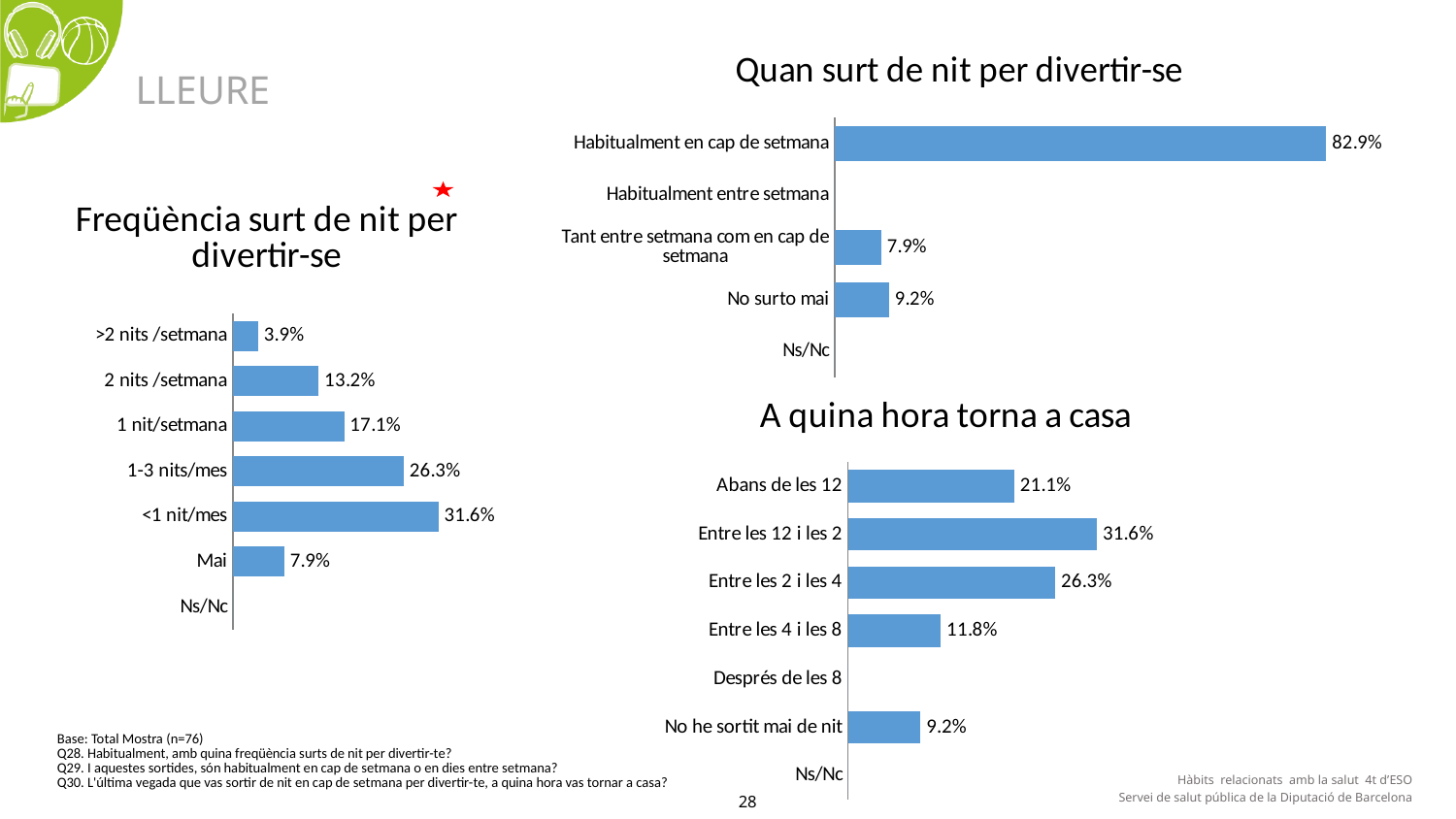
In the chart 'A quina hora torna a casa', what is the value for 'Entre les 4 i les 8'? 11.8% In the chart 'Freqüència surt de nit per divertir-se', what is the difference between '1-3 nits/mes' and '1 nit/setmana'? 9.2% In the chart 'A quina hora torna a casa', what is the difference between 'Entre les 12 i les 2' and 'Abans de les 12'? 10.5% In the chart 'Quan surt de nit per divertir-se', what is the value for 'Habitualment en cap de setmana'? 82.9% What type of chart is 'Quan surt de nit per divertir-se'? Bar chart In the chart 'Quan surt de nit per divertir-se', what is the difference between 'Habitualment en cap de setmana' and 'No surto mai'? 73.7% In the chart 'Freqüència surt de nit per divertir-se', what is the value for '<1 nit/mes'? 31.6% In the chart 'Freqüència surt de nit per divertir-se', which category has the lowest labelled value? >2 nits /setmana In the chart 'A quina hora torna a casa', which category has the highest value? Entre les 12 i les 2 How many categories are listed on the axis of the chart 'Freqüència surt de nit per divertir-se'? 7 How many categories are listed on the axis of the chart 'A quina hora torna a casa'? 7 In the chart 'Quan surt de nit per divertir-se', which is larger: 'No surto mai' or 'Tant entre setmana com en cap de setmana'? No surto mai